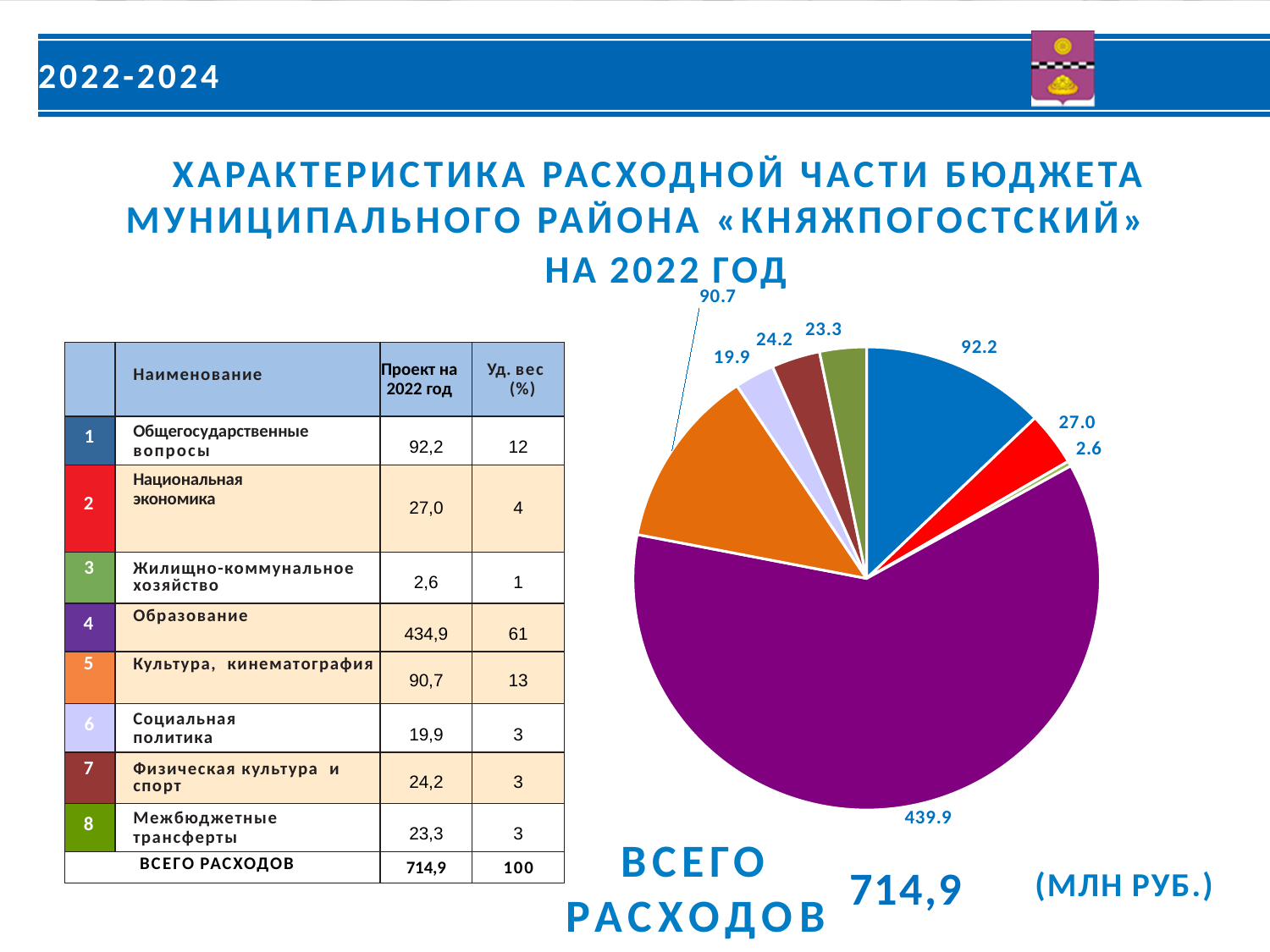
What value is labelled on the light lavender slice of the pie chart? 19.9 What value is labelled on the red slice of the pie chart? 27.0 What total expenditure figure (ВСЕГО РАСХОДОВ) is shown next to the pie chart? 714,9 (млн руб.) What value is labelled on the blue slice of the pie chart? 92.2 Which slice is larger in the pie chart, the blue slice or the orange slice? the blue slice What value is labelled on the largest (purple) slice of the pie chart? 439.9 What kind of chart is shown on the slide? pie chart Which is larger in the pie chart, the slice labelled 24.2 or the slice labelled 23.3? 24.2 What value is labelled on the smallest slice of the pie chart? 2.6 What value is labelled on the orange slice of the pie chart? 90.7 How many slices does the pie chart have? 8 What is the difference between the blue slice (92.2) and the orange slice (90.7) in the pie chart? 1.5